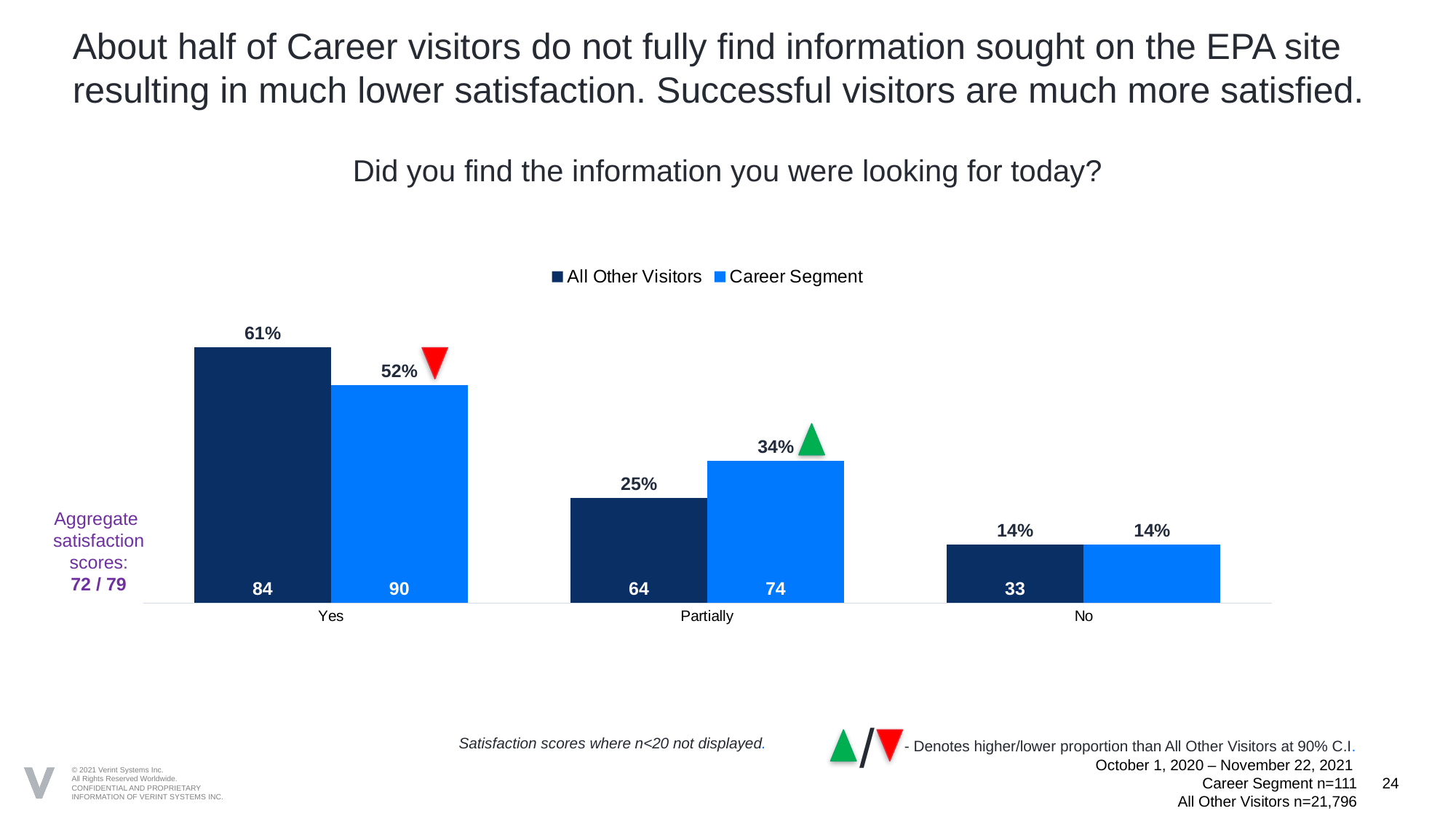
How many series does the legend list? 2 What is the satisfaction score shown inside the All Other Visitors bar for No? 33 Which response category has the lowest percentage for All Other Visitors? No How many response categories are shown on the x axis? 3 What percentage of the Career Segment answered Partially? 34% For Partially, which series has the larger percentage: All Other Visitors or Career Segment? Career Segment What kind of chart is shown on the slide? Bar chart What percentage of the Career Segment answered No? 14% What percentage of All Other Visitors answered Yes? 61% What is the satisfaction score shown inside the Career Segment bar for Yes? 90 Which response category has the highest percentage for the Career Segment? Yes What is the difference between the All Other Visitors and Career Segment percentages for Yes? 9%